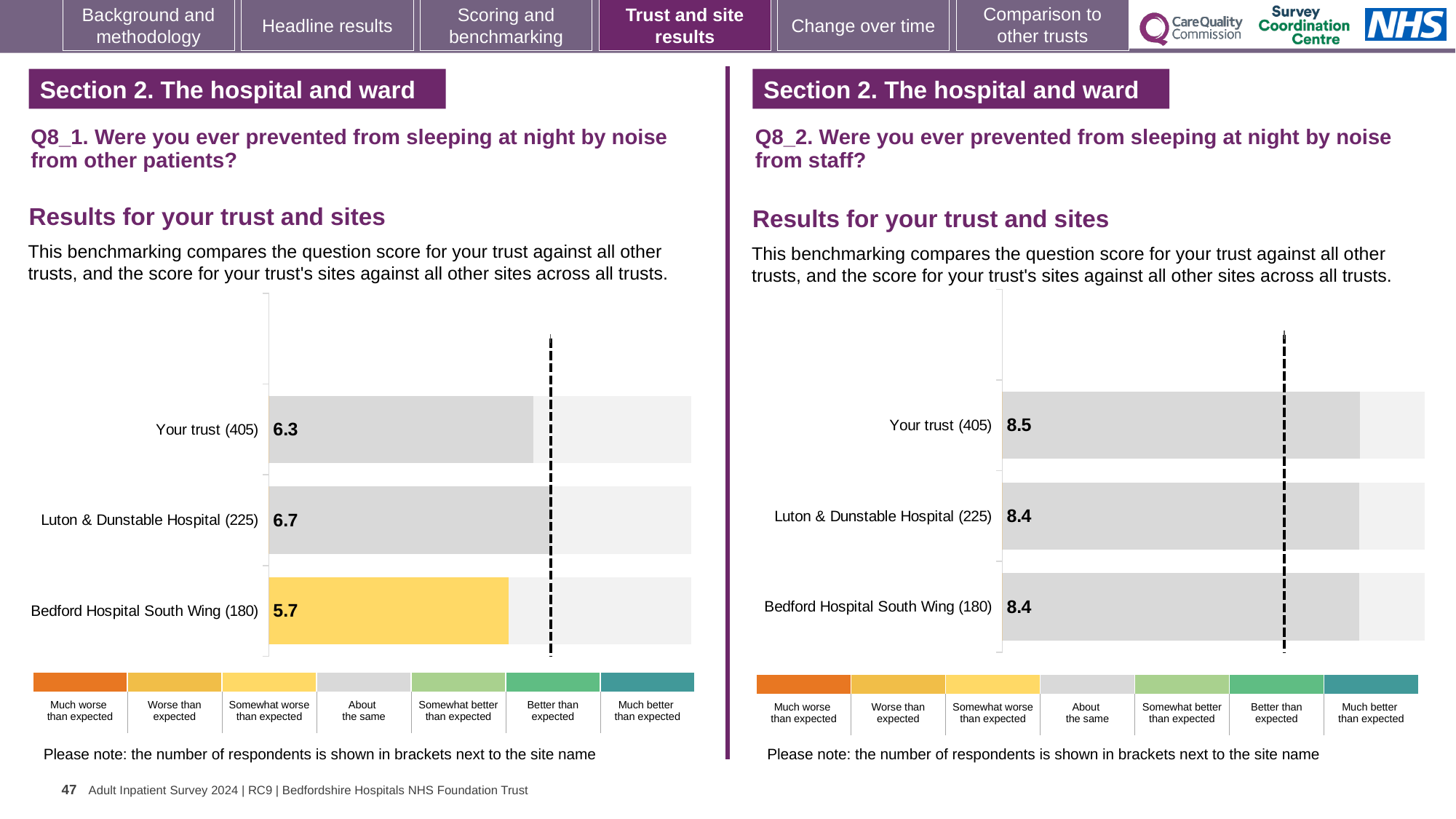
On the Q8_2 chart (noise from staff), which has the higher score, Your trust or Luton & Dunstable Hospital? Your trust On the Q8_1 chart (noise from other patients), which site or trust has the highest score? Luton & Dunstable Hospital How many bars are plotted on the Q8_2 chart (noise from staff)? 3 On the Q8_1 chart (noise from other patients), what is the difference between the Luton & Dunstable Hospital score and the Bedford Hospital South Wing score? 1.0 On the Q8_1 chart (noise from other patients), which site or trust has the lowest score? Bedford Hospital South Wing What type of chart is used on the Q8_1 chart (noise from other patients)? Bar chart On the Q8_1 chart (noise from other patients), what is the score for Your trust? 6.3 On the Q8_1 chart (noise from other patients), what is the score for Bedford Hospital South Wing? 5.7 On the Q8_2 chart (noise from staff), what is the score for Your trust? 8.5 On the Q8_1 chart (noise from other patients), which benchmark category does the coloured bar for Bedford Hospital South Wing fall into? Somewhat worse than expected On the Q8_2 chart (noise from staff), what is the score for Bedford Hospital South Wing? 8.4 On the Q8_1 chart (noise from other patients), what is the score for Luton & Dunstable Hospital? 6.7